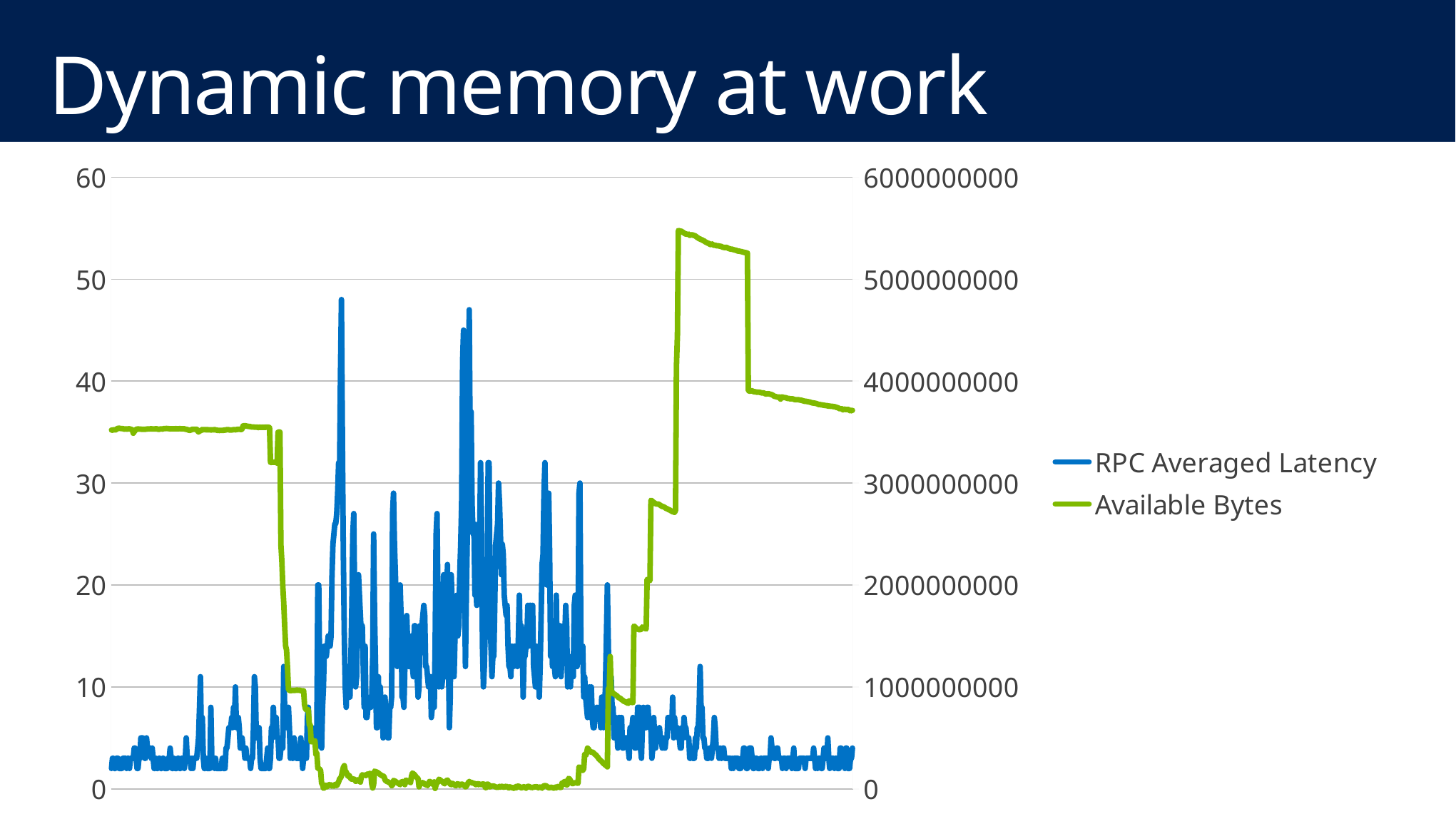
What is the title of the slide containing the chart? Dynamic memory at work Is the lowest value of Available Bytes greater or less than 1000000000? less Is the value of Available Bytes at the far right end of the chart greater or less than 3000000000? greater What is the maximum tick value on the right vertical axis? 6000000000 Is the highest value of RPC Averaged Latency greater or less than 40? greater Which series is drawn in green? Available Bytes What is the maximum tick value on the left vertical axis? 60 How many series does the legend list? 2 What kind of chart is shown on the slide? line chart